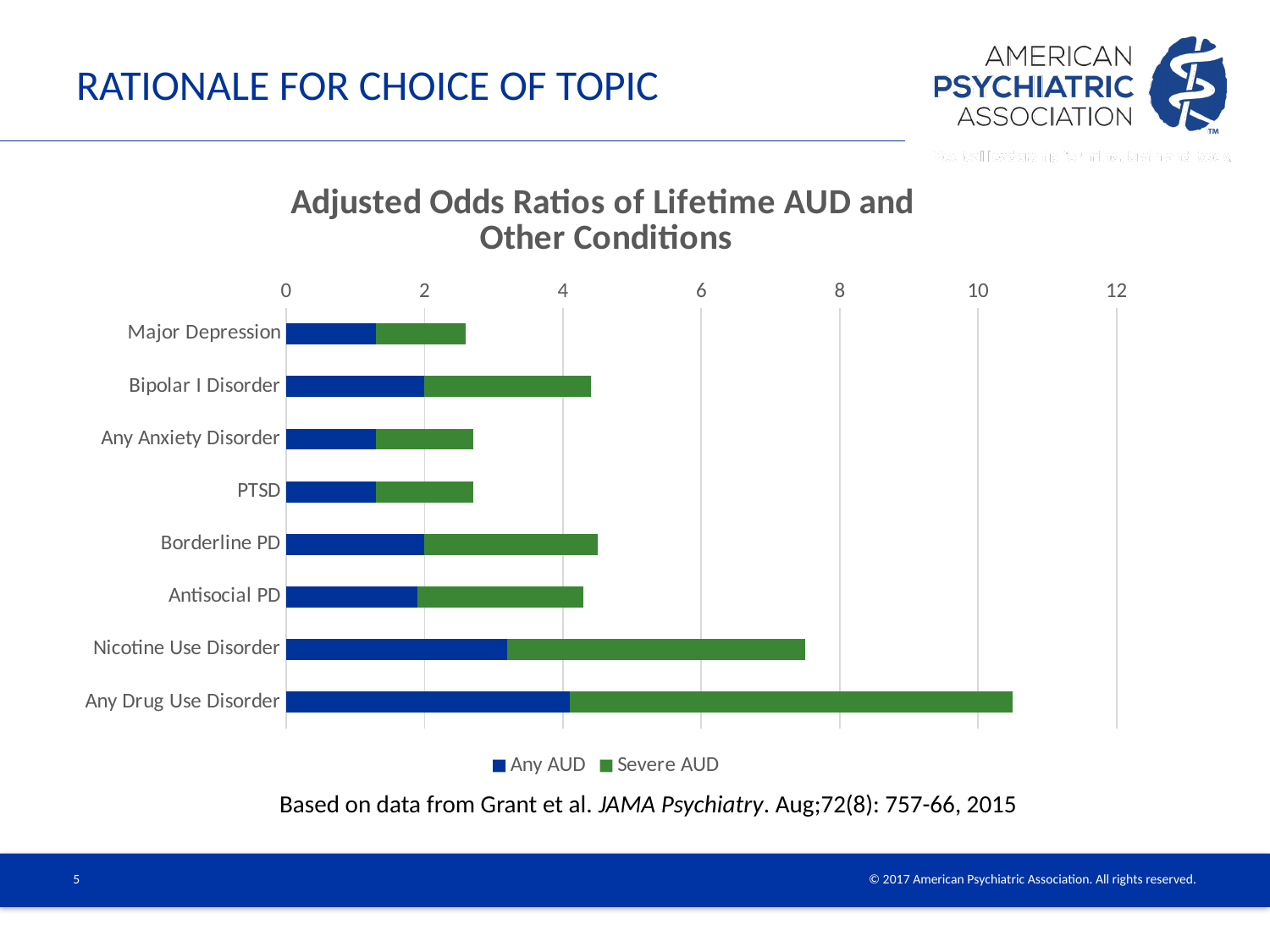
Is the total bar for Bipolar I Disorder greater or less than 4? greater Is the total bar for Nicotine Use Disorder greater or less than 8? less Is the Any AUD value for Nicotine Use Disorder greater or less than 4? less Which condition has the highest total adjusted odds ratio in the chart? Any Drug Use Disorder What kind of chart is shown on the slide? Stacked bar chart How many conditions (categories) are plotted in the chart? 8 Which has a larger total bar, Nicotine Use Disorder or Bipolar I Disorder? Nicotine Use Disorder Which has a larger total bar, Any Drug Use Disorder or Borderline PD? Any Drug Use Disorder What is the title of the chart? Adjusted Odds Ratios of Lifetime AUD and Other Conditions How many series does the legend list? 2